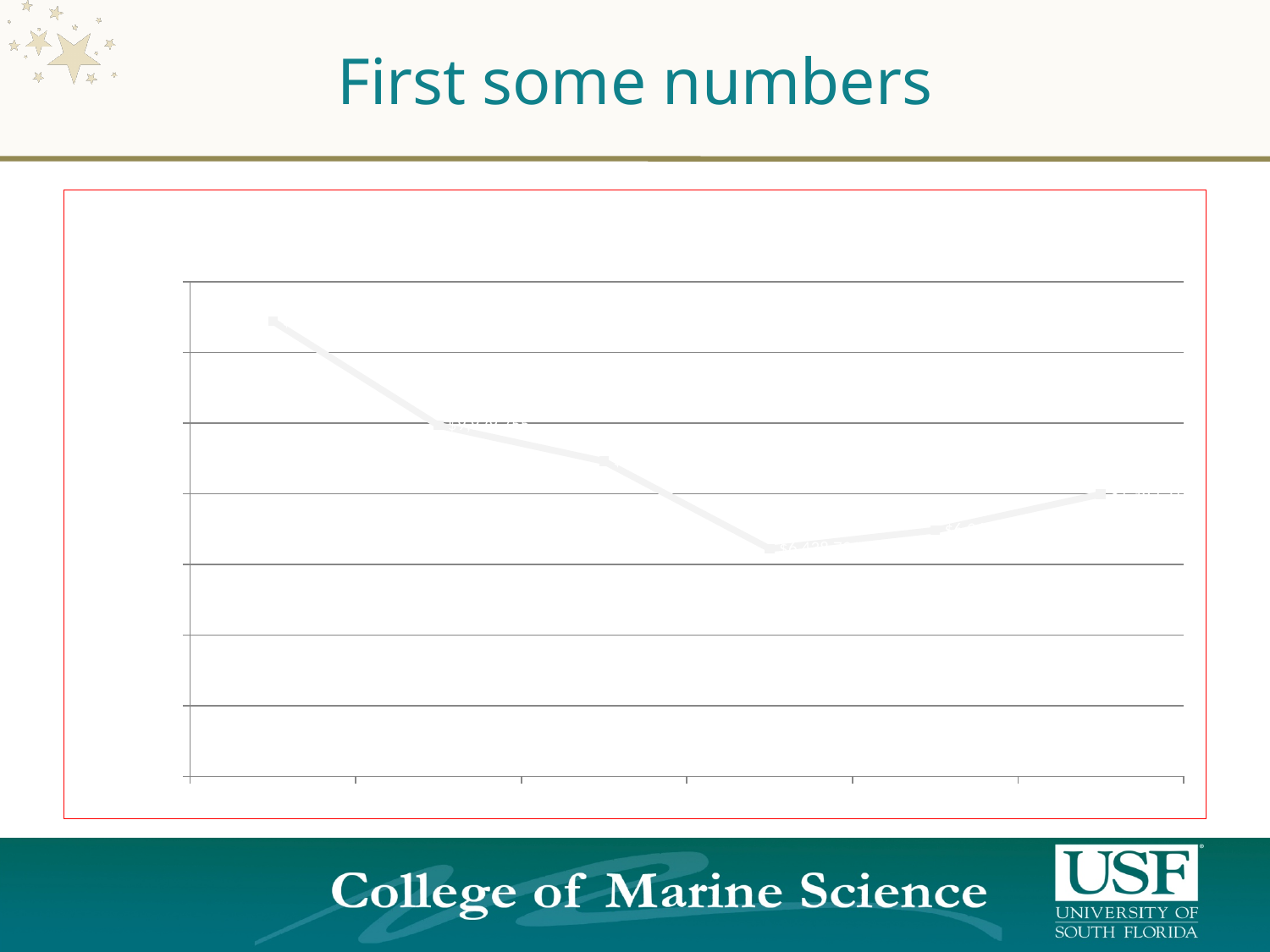
Which data point on the line is the lowest? the fourth point Which is larger, the value at the first point or the value at the last point? the first point How many lines are plotted on the chart? 1 Does the line rise or fall between the first and fourth data points? fall Which is larger, the value at the second point or the value at the fifth point? the second point How many data points are plotted on the line? 6 Does the line rise or fall between the fourth and sixth data points? rise Which data point on the line is the highest? the first point What is the title of the slide containing the chart? First some numbers What kind of chart is shown on the slide? line chart